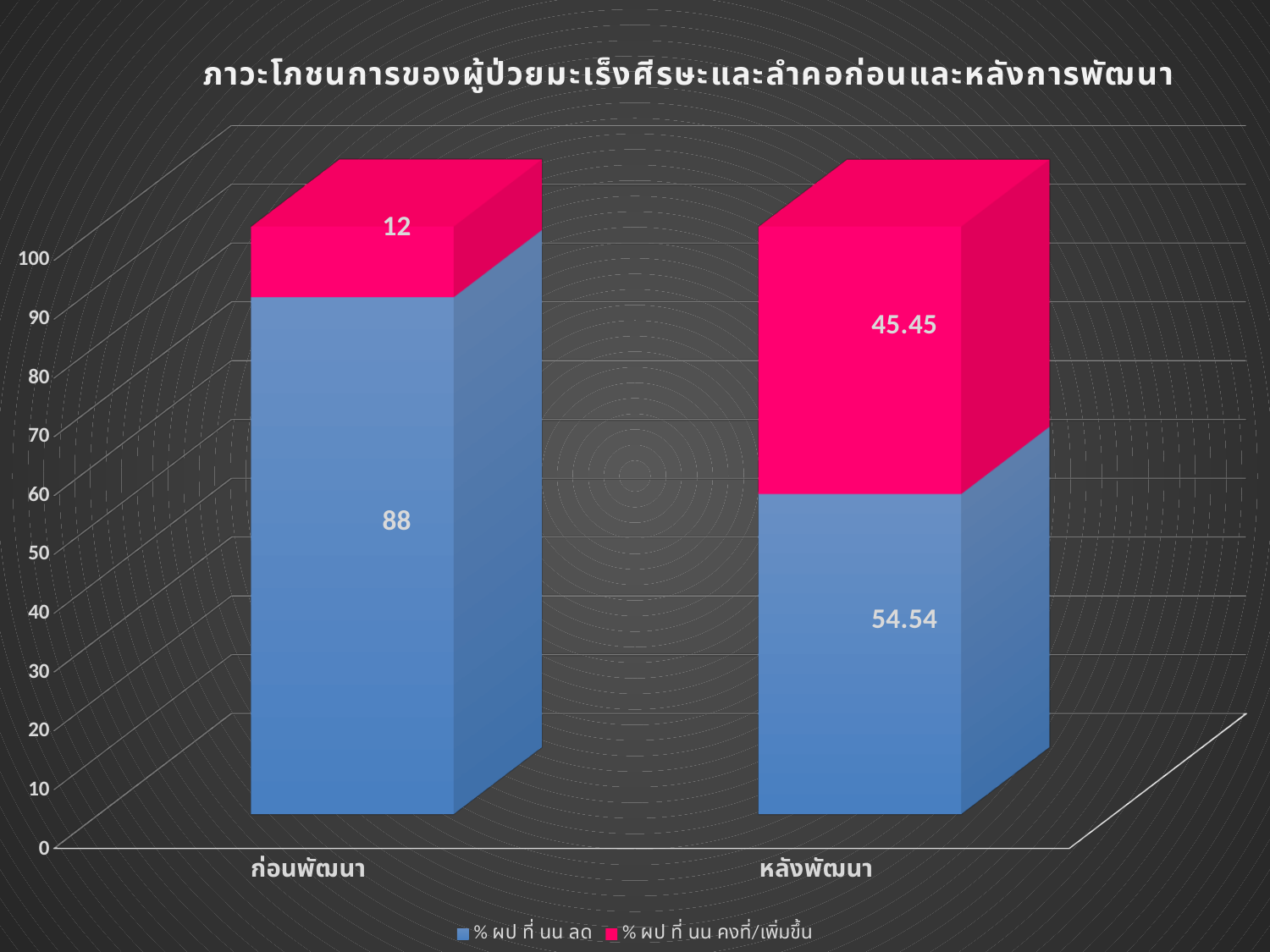
Which category has the higher value for % ผป ที่ นน ลด, ก่อนพัฒนา or หลังพัฒนา? ก่อนพัฒนา What kind of chart is shown on the slide? Stacked bar chart What is the value of % ผป ที่ นน ลด for หลังพัฒนา? 54.54 What is the total of the stacked bar for หลังพัฒนา? 99.99 What is the total of the stacked bar for ก่อนพัฒนา? 100 How many series does the legend list? 2 How many categories are shown on the x axis? 2 Which category has the highest value for % ผป ที่ นน คงที่/เพิ่มขึ้น? หลังพัฒนา What is the value of % ผป ที่ นน คงที่/เพิ่มขึ้น for ก่อนพัฒนา? 12 What is the value of % ผป ที่ นน ลด for ก่อนพัฒนา? 88 What is the difference between the % ผป ที่ นน ลด values for ก่อนพัฒนา and หลังพัฒนา? 33.46 What is the value of % ผป ที่ นน คงที่/เพิ่มขึ้น for หลังพัฒนา? 45.45